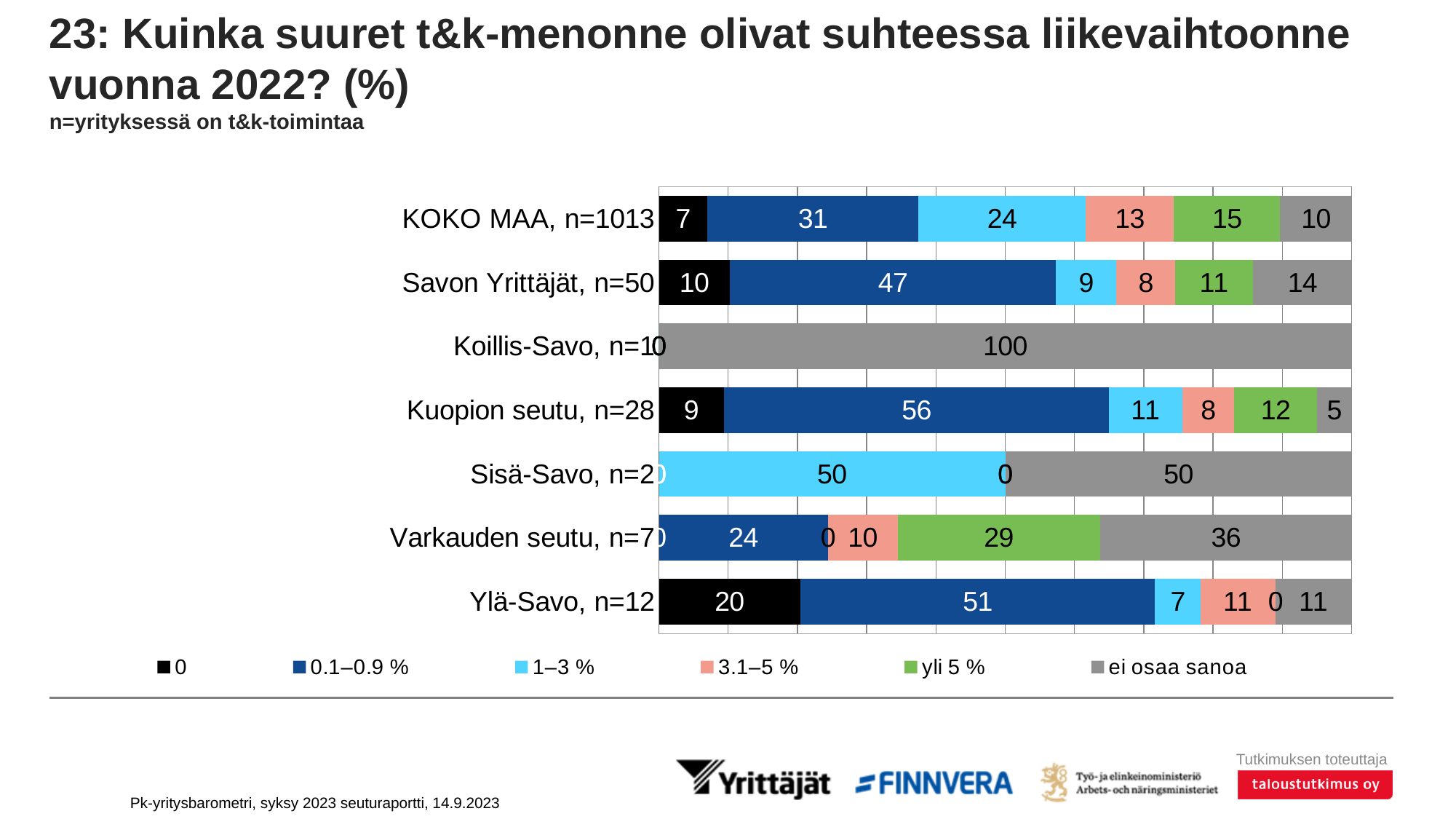
How many series does the legend list? 6 How many categories (rows) are plotted in the chart? 7 What is the value of the 0.1–0.9 % series for KOKO MAA, n=1013? 31 What is the value of the 0 series for Ylä-Savo, n=12? 20 Which legend entry is shown in green? yli 5 % Which is larger: the 1–3 % value for KOKO MAA, n=1013 or for Savon Yrittäjät, n=50? KOKO MAA, n=1013 What kind of chart is shown on the slide? Stacked bar chart What is the value of the 'ei osaa sanoa' series for Koillis-Savo, n=10? 100 Which category has the lowest value in the 'ei osaa sanoa' series? Kuopion seutu, n=28 What is the value of the 'yli 5 %' series for Varkauden seutu, n=7? 29 Which category has the highest value in the 0.1–0.9 % series? Kuopion seutu, n=28 What is the difference between the 0.1–0.9 % values for Savon Yrittäjät, n=50 and KOKO MAA, n=1013? 16